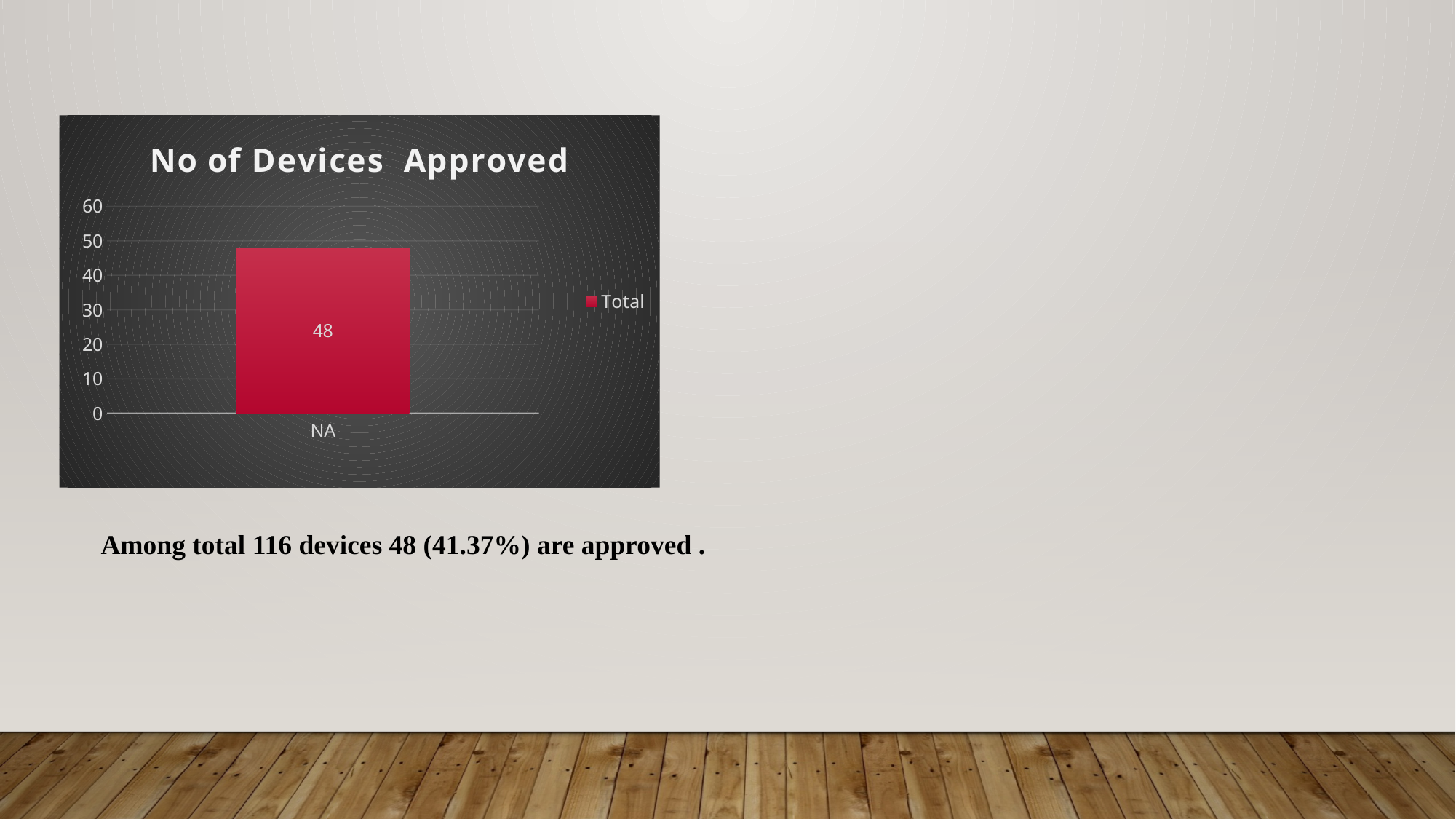
What is the title of the chart? No of Devices Approved What series name is shown in the chart's legend? Total How many categories are plotted on the x axis of the chart? 1 What kind of chart is shown on the slide? bar chart Is the value for NA greater or less than 50? less How many series does the chart's legend list? 1 Is the value for NA greater or less than 40? greater What is the value of the bar for NA in the chart? 48 What is the category label shown under the bar in the chart? NA What is the highest value shown on the chart's vertical axis? 60